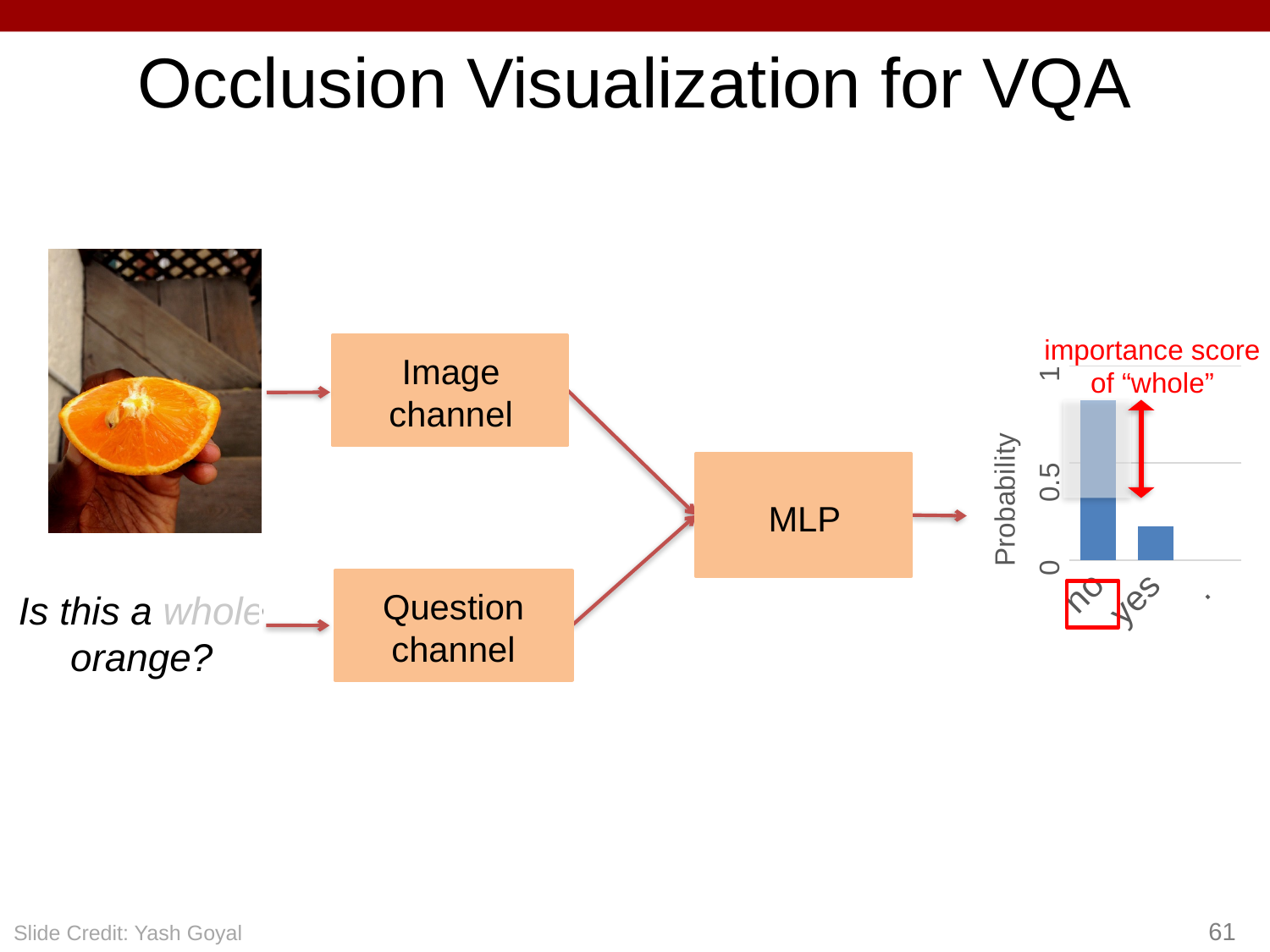
What kind of chart is shown on the right of the slide? bar chart What is the label of the vertical axis of the bar chart? Probability Which category in the bar chart has the highest probability? no Is the light blue bar for "no" greater or less than 0.5? greater Which has the larger probability in the bar chart, "no" or "yes"? no Is the probability for "yes" greater or less than 0.5? less Which category label on the bar chart is outlined with a red box? no Which category in the bar chart has the lowest probability? yes What does the red double-headed arrow on the bar chart represent, according to the annotation? importance score of "whole"